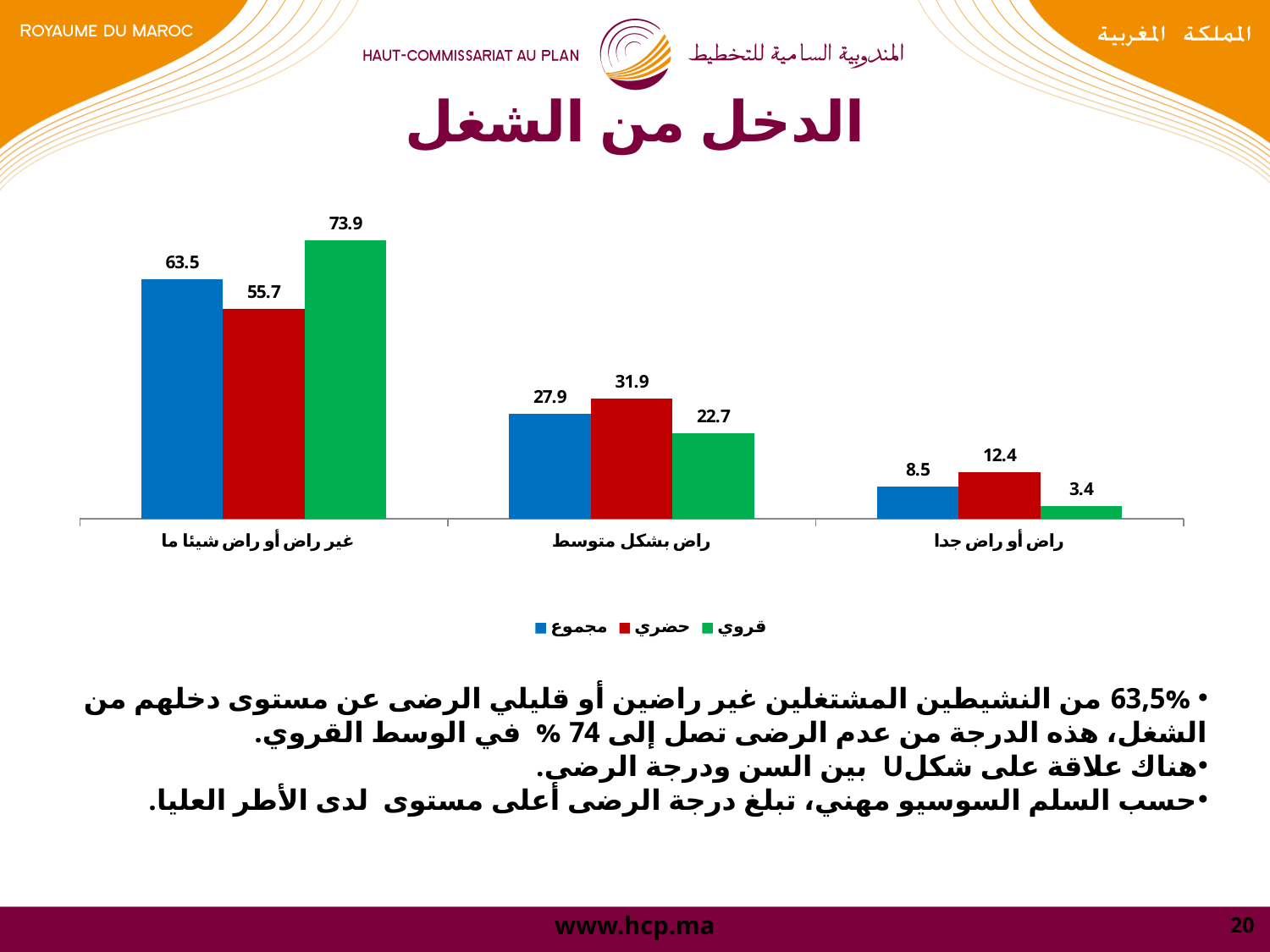
Which category has the lowest value for the مجموع series? راض أو راض جدا How many categories are shown on the x axis? 3 What is the value of the قروي series for the category غير راض أو راض شيئا ما? 73.9 How many series does the legend list? 3 Which category has the highest value for the حضري series? غير راض أو راض شيئا ما What is the value of the مجموع series for the category غير راض أو راض شيئا ما? 63.5 What is the value of the حضري series for the category راض بشكل متوسط? 31.9 What is the value of the قروي series for the category راض أو راض جدا? 3.4 What type of chart is shown on the slide? bar chart What is the difference between the قروي and حضري values for the category غير راض أو راض شيئا ما? 18.2 For the category راض أو راض جدا, which is larger: the حضري value or the مجموع value? حضري Which colour represents the قروي series in the legend? green